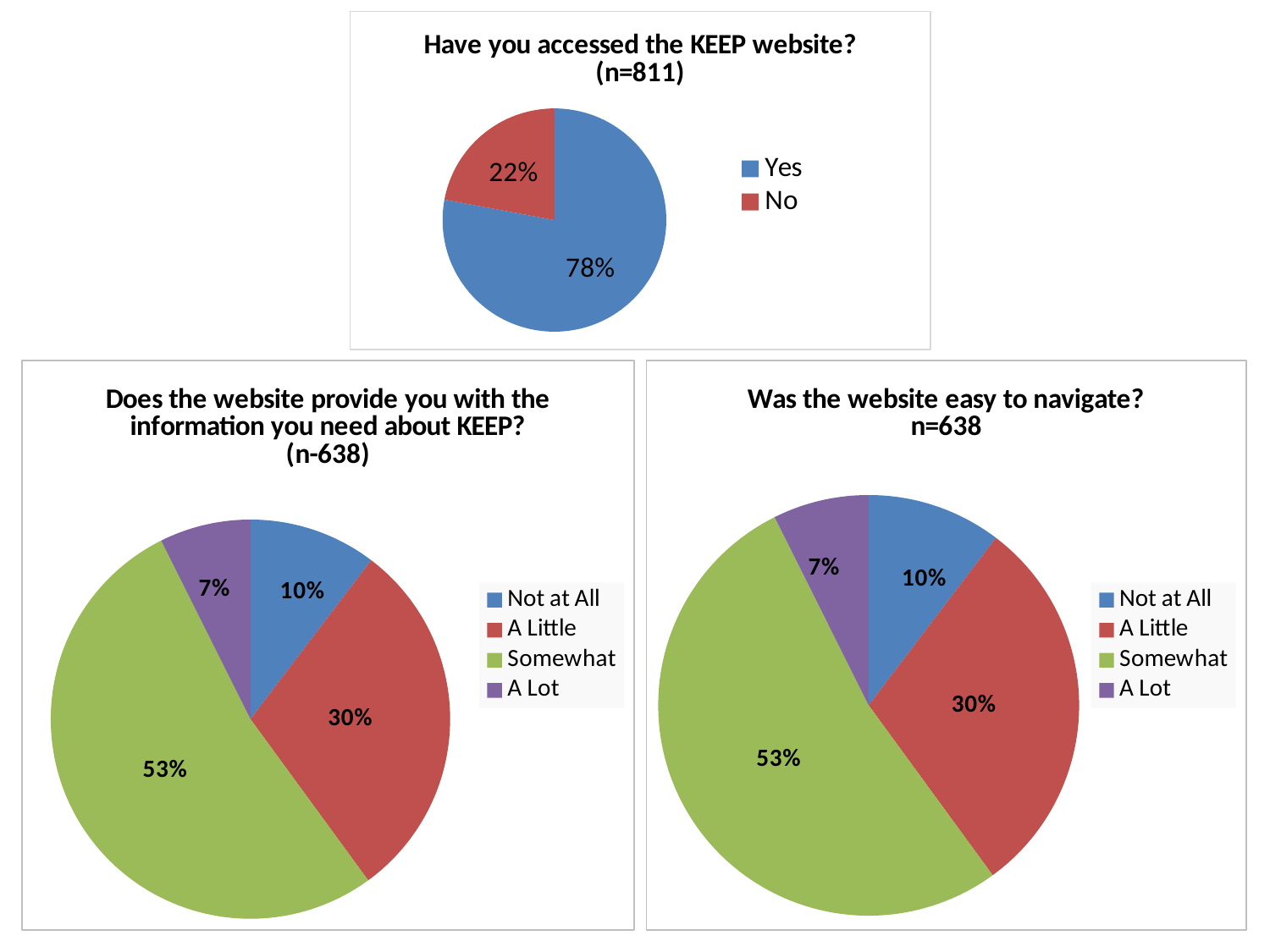
What kind of chart is used in the top chart titled "Have you accessed the KEEP website?"? Pie chart In the chart titled "Have you accessed the KEEP website?", what percentage answered Yes? 78% In the chart titled "Was the website easy to navigate?", which response has the largest share? Somewhat In the chart titled "Was the website easy to navigate?", what percentage answered A Little? 30% In the chart titled "Was the website easy to navigate?", which is larger: the share for Not at All or the share for A Lot? Not at All In the chart titled "Have you accessed the KEEP website?", what percentage answered No? 22% In the chart titled "Was the website easy to navigate?", what is the difference between the Somewhat and A Little shares? 23% In the chart titled "Does the website provide you with the information you need about KEEP?", what percentage answered Somewhat? 53% In the chart titled "Does the website provide you with the information you need about KEEP?", which response has the smallest share? A Lot In the chart titled "Does the website provide you with the information you need about KEEP?", how many categories does the legend list? 4 In the chart titled "Have you accessed the KEEP website?", what is the difference between the Yes and No shares? 56% In the chart titled "Have you accessed the KEEP website?", what colour is the Yes slice? Blue